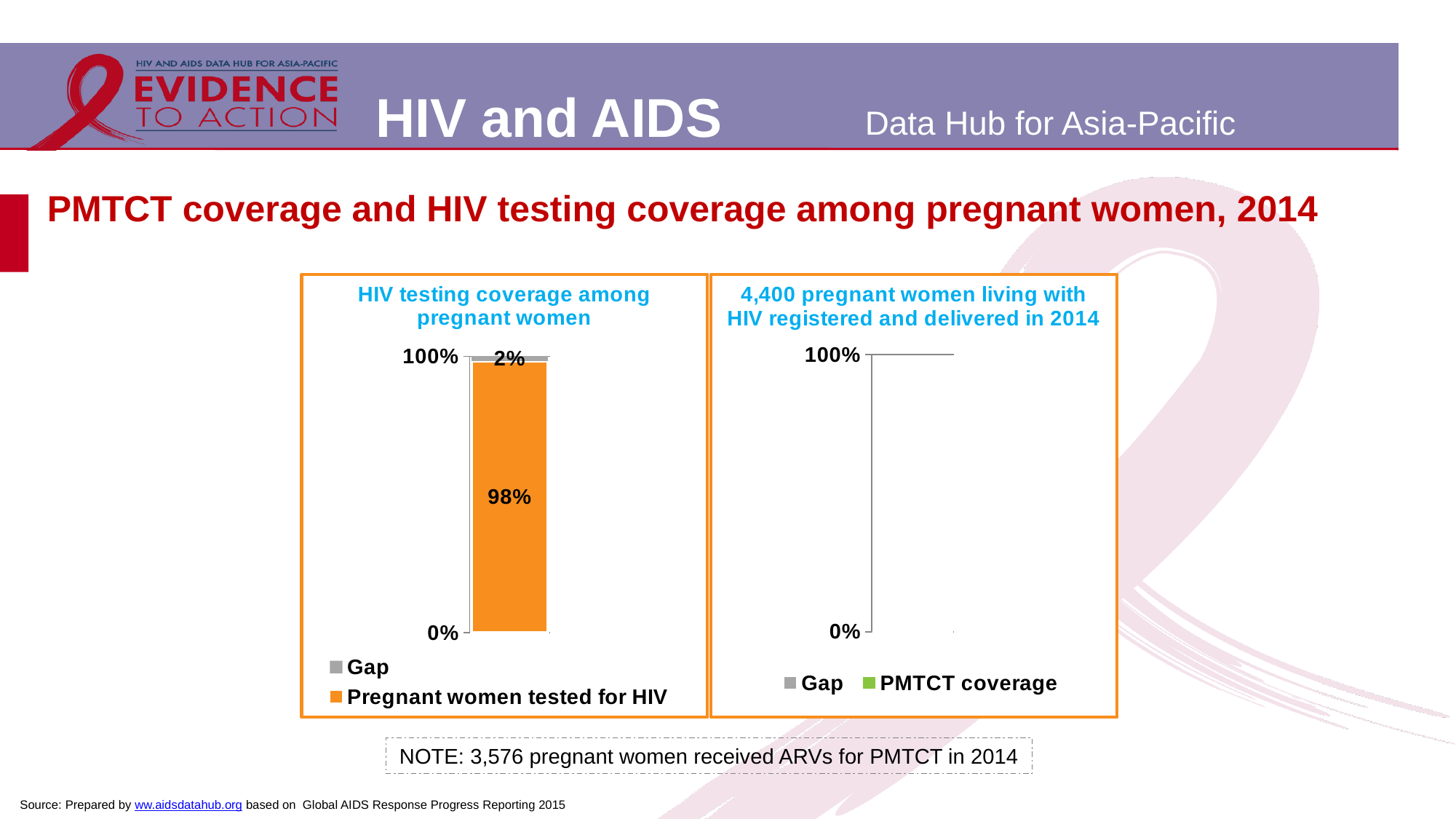
How many series does the legend of the chart titled 'HIV testing coverage among pregnant women' list? 2 In the chart titled 'HIV testing coverage among pregnant women', is the value for Pregnant women tested for HIV greater or less than 50%? greater In the chart titled 'HIV testing coverage among pregnant women', what is the value for Gap? 2% In the chart titled 'HIV testing coverage among pregnant women', what is the value for Pregnant women tested for HIV? 98% In the chart titled 'HIV testing coverage among pregnant women', which series is shown in orange? Pregnant women tested for HIV In the chart titled 'HIV testing coverage among pregnant women', what is the total of the stacked bar? 100% In the chart titled 'HIV testing coverage among pregnant women', which segment is larger: Gap or Pregnant women tested for HIV? Pregnant women tested for HIV What kind of chart is the one titled 'HIV testing coverage among pregnant women'? Stacked bar chart In the chart titled 'HIV testing coverage among pregnant women', what is the difference between the Pregnant women tested for HIV value and the Gap value? 96% What are the two legend entries of the chart titled '4,400 pregnant women living with HIV registered and delivered in 2014'? Gap and PMTCT coverage How many series does the legend of the chart titled '4,400 pregnant women living with HIV registered and delivered in 2014' list? 2